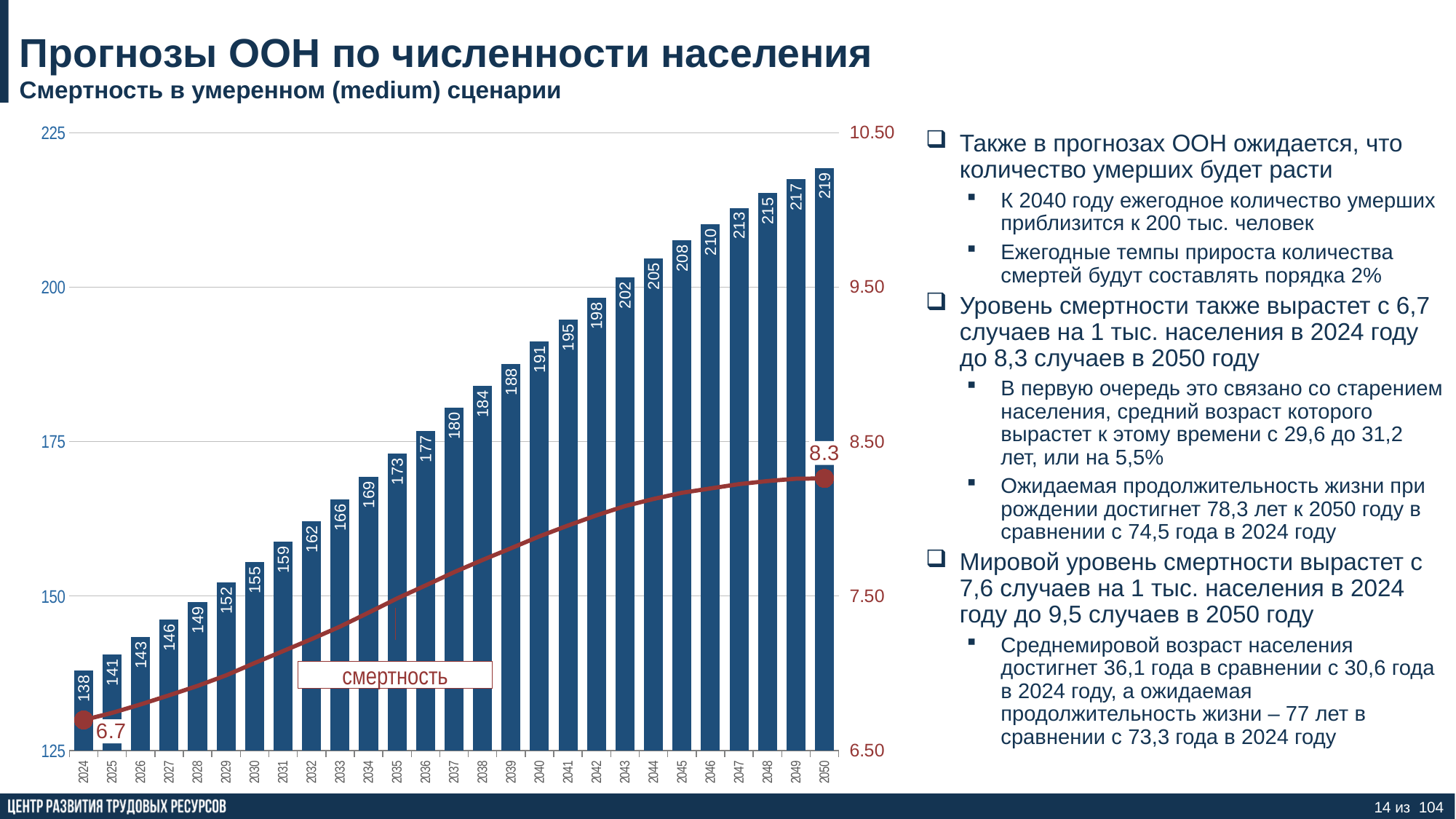
What is the value of the bar for 2024? 138 What is the difference between the bar values for 2050 and 2024? 81 How many bars (years) are shown in the chart? 27 Which is larger, the bar for 2035 or the bar for 2045? 2045 Do the bar values rise or fall from 2024 to 2050? rise What is the label shown on the line series in the chart? смертность What value does the 'смертность' line show for 2024? 6.7 Which year has the lowest bar? 2024 What is the value of the bar for 2050? 219 What is the value of the bar for 2040? 191 What value does the 'смертность' line show for 2050? 8.3 Which year has the highest bar? 2050